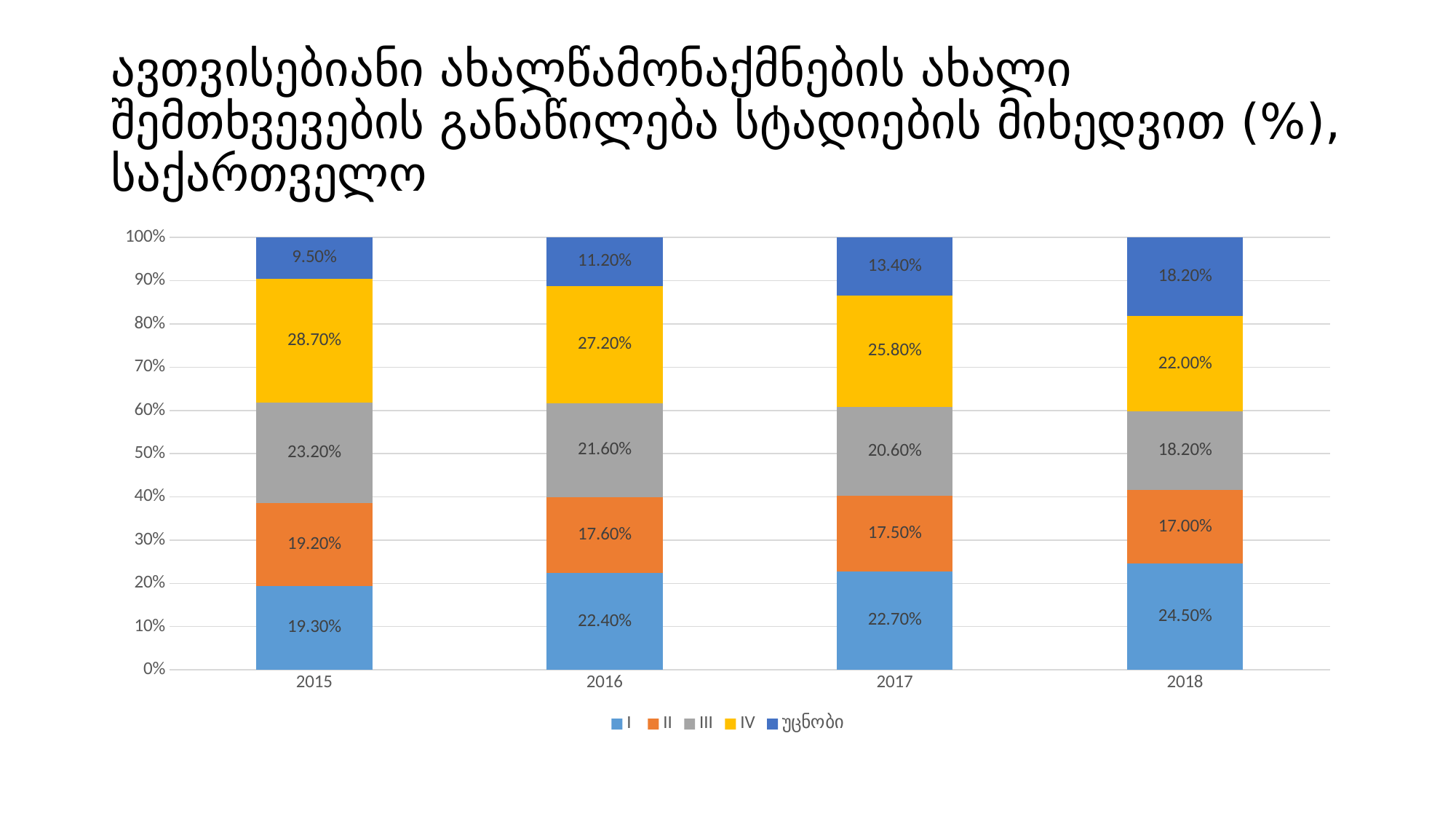
What is the difference between the value for series IV in 2015 and in 2018? 6.70% What is the value for series I in 2018? 24.50% In which year is the value for უცნობი the lowest? 2015 What is the total of the stacked bar for 2016? 100.00% Does the value for series I rise or fall from 2015 to 2018? Rise In which year is the value for series IV the highest? 2015 What is the value for series IV in 2015? 28.70% How many years are shown on the x axis? 4 What is the value for უცნობი in 2017? 13.40% Which is larger: the value for series III in 2016 or the value for series III in 2018? 2016 How many series does the legend list? 5 What kind of chart is shown on the slide? Stacked bar chart